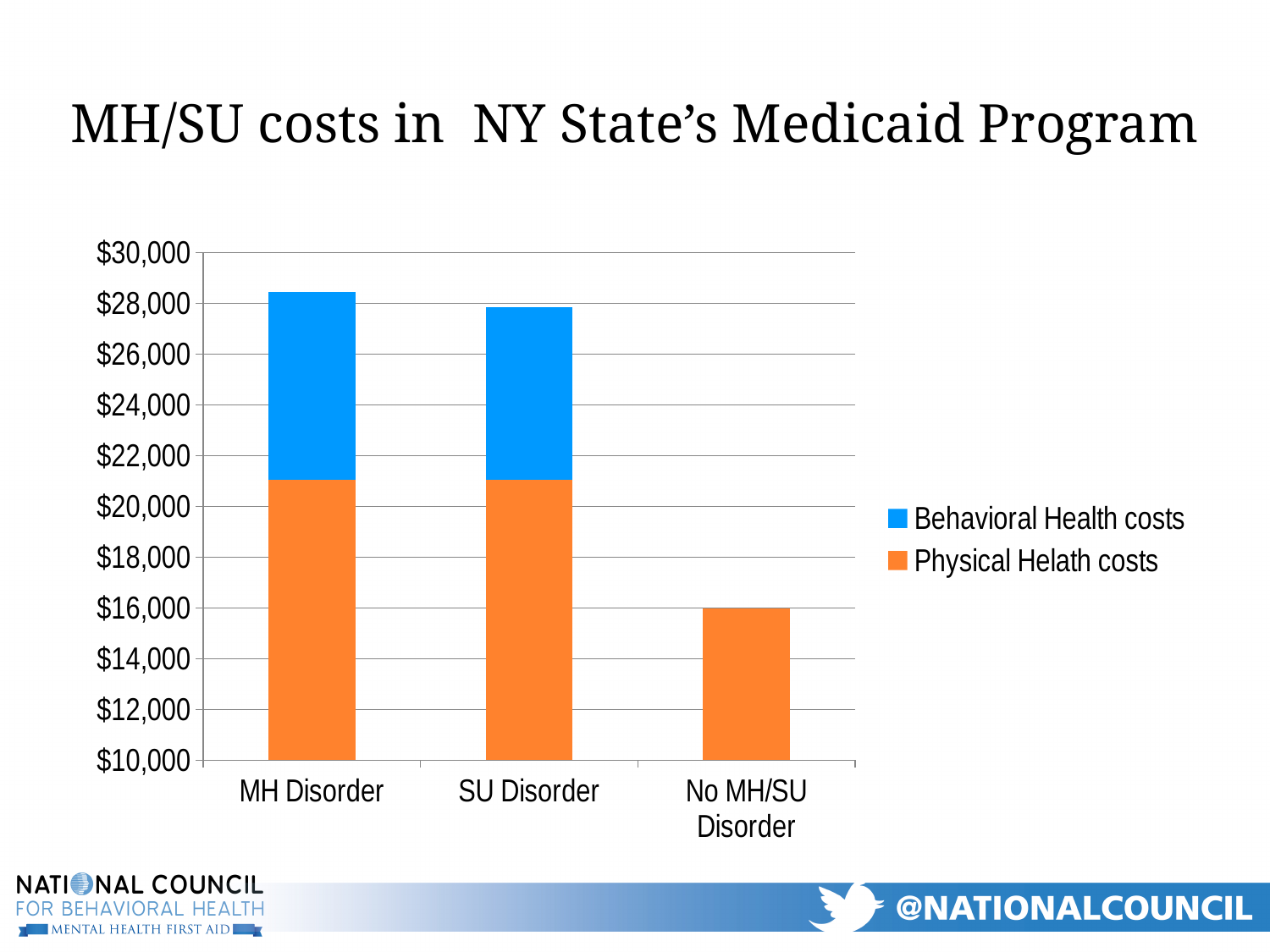
What kind of chart is shown on the slide? Stacked bar chart Which category has the lowest total cost? No MH/SU Disorder Is the total cost for MH Disorder greater or less than $28,000? greater How many series does the chart's legend list? 2 Is the Physical Helath costs value for No MH/SU Disorder greater or less than $18,000? less What is the title of the chart on the slide? MH/SU costs in NY State's Medicaid Program Which is larger, the total cost for SU Disorder or for No MH/SU Disorder? SU Disorder Which series is shown in orange in the chart? Physical Helath costs Is the Physical Helath costs value for MH Disorder greater or less than $20,000? greater Which category has the highest total cost? MH Disorder How many categories are shown on the x axis of the chart? 3